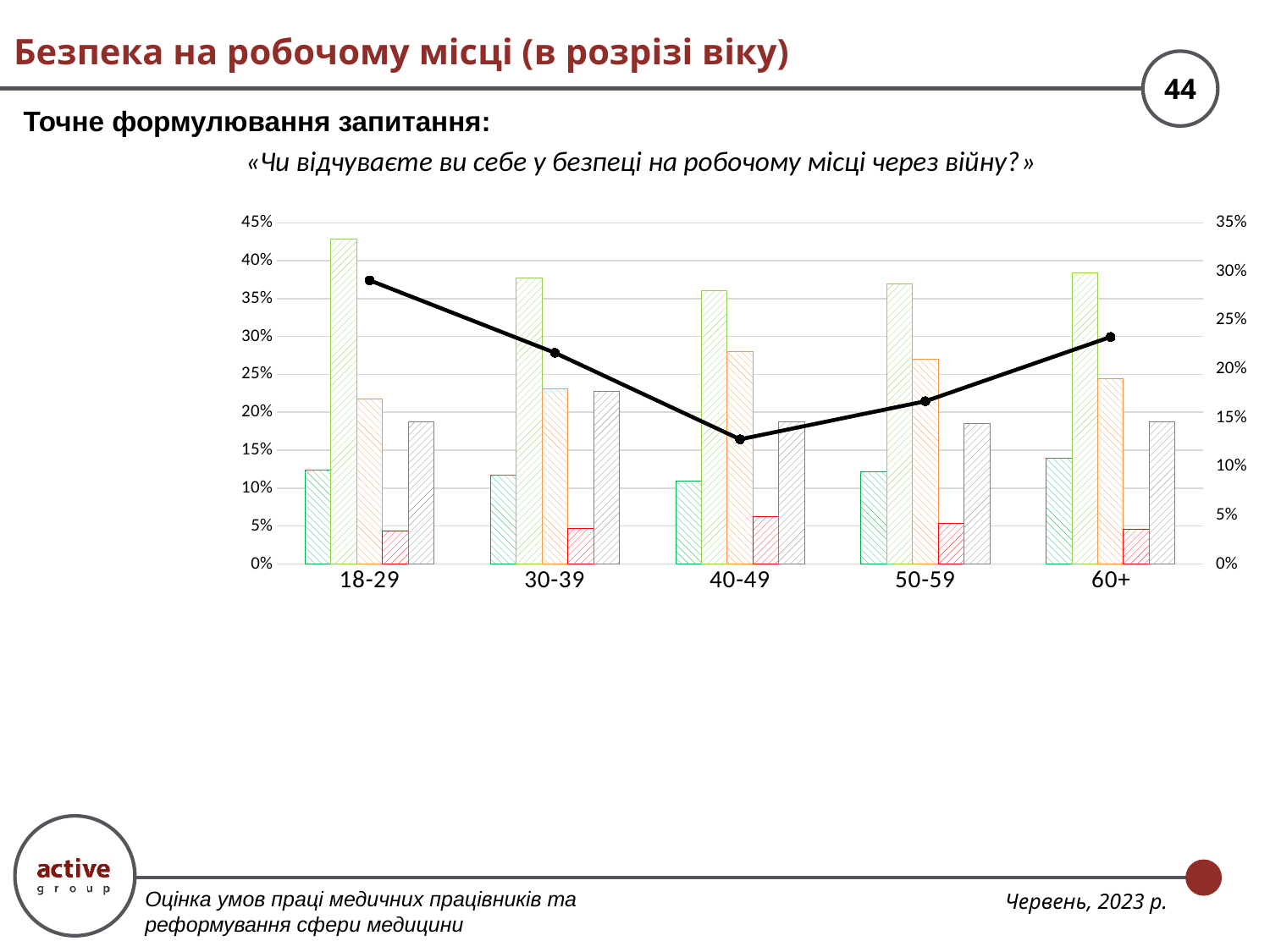
Does the black line rise or fall from 40-49 to 60+? rises How many age groups are shown on the x axis of the chart? 5 On the right-hand axis, is the black line value for 40-49 greater or less than 15%? less On the right-hand axis, is the black line value for 60+ greater or less than 20%? greater Which age group contains the tallest bar in the chart? 18-29 Which age group has the highest point on the black line? 18-29 Which age group has the lowest point on the black line? 40-49 What is the maximum value shown on the left-hand vertical axis? 45% Does the black line rise or fall from 18-29 to 40-49? falls On the right-hand axis, is the black line value for 18-29 greater or less than 25%? greater What kind of chart is shown on the slide? A bar chart combined with a line Is the black line value for 30-39 larger or smaller than the value for 50-59? larger